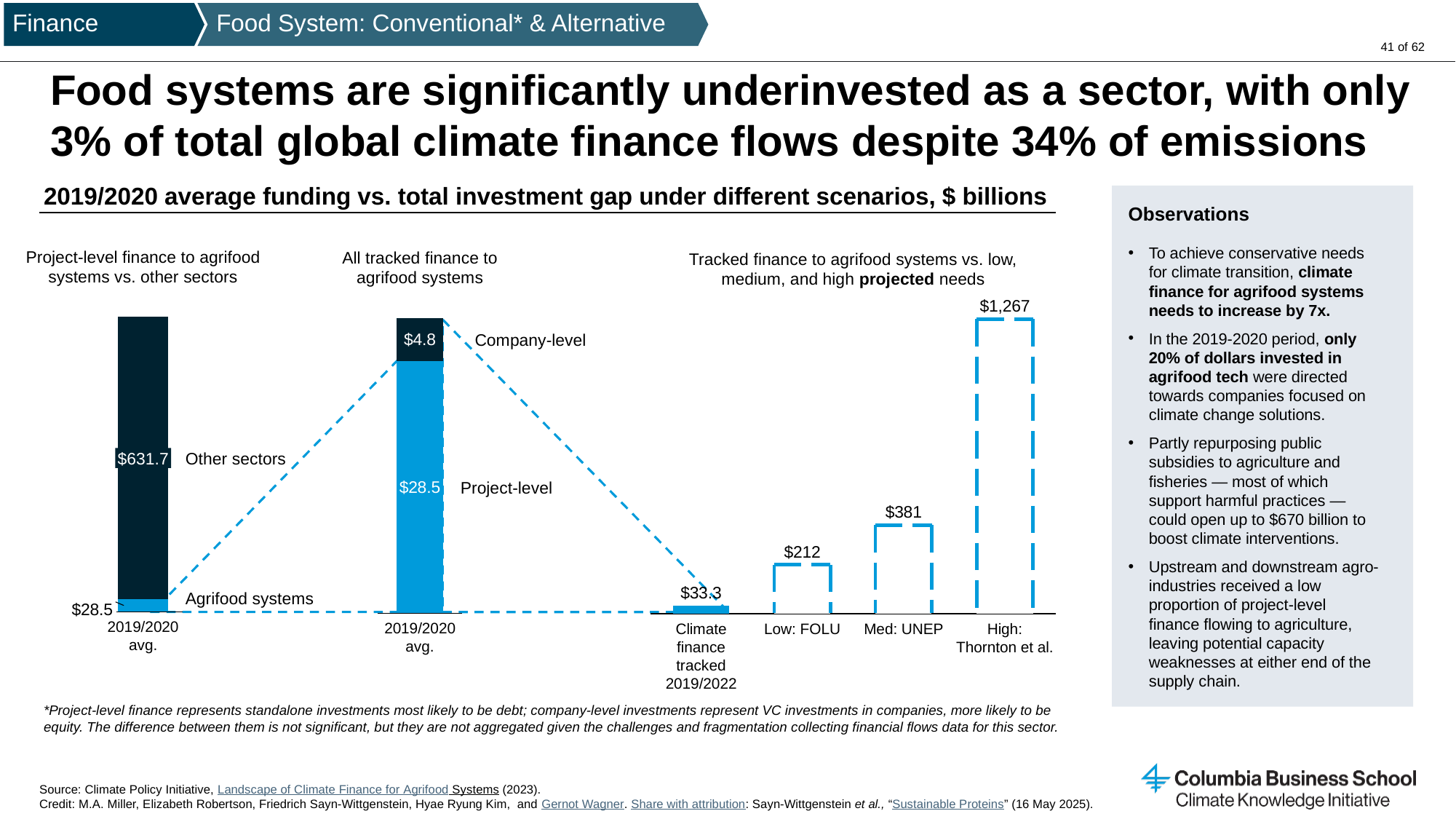
In the chart 'Project-level finance to agrifood systems vs. other sectors', what is the value for Other sectors? $631.7 In the chart 'Tracked finance to agrifood systems vs. low, medium, and high projected needs', what is the value for Med: UNEP? $381 In the chart 'Project-level finance to agrifood systems vs. other sectors', which is larger, Other sectors or Agrifood systems? Other sectors In the chart 'Tracked finance to agrifood systems vs. low, medium, and high projected needs', how many bars are shown? 4 In the chart 'All tracked finance to agrifood systems', what is the total of the stacked bar (Company-level plus Project-level)? $33.3 In the chart 'Project-level finance to agrifood systems vs. other sectors', what is the value for Agrifood systems? $28.5 What kind of chart is used in the 'All tracked finance to agrifood systems' panel? Stacked bar chart What unit is stated in the chart title for the values shown? $ billions In the chart 'Tracked finance to agrifood systems vs. low, medium, and high projected needs', which category has the lowest value? Climate finance tracked 2019/2022 In the chart 'All tracked finance to agrifood systems', what is the Company-level value? $4.8 In the chart 'Tracked finance to agrifood systems vs. low, medium, and high projected needs', which category has the highest value? High: Thornton et al. In the chart 'Tracked finance to agrifood systems vs. low, medium, and high projected needs', what is the difference between Med: UNEP and Low: FOLU? $169